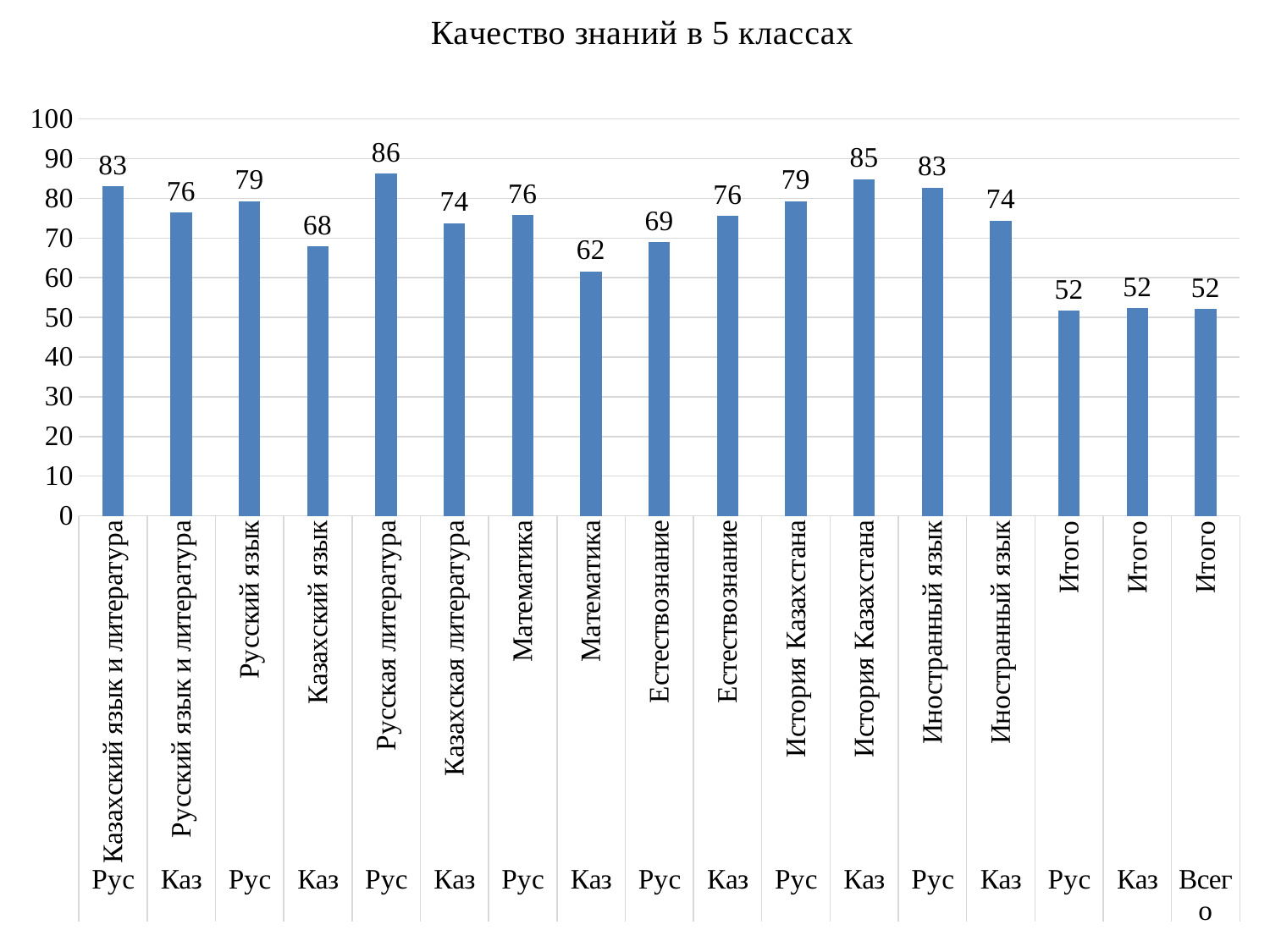
Which category has the highest value? Русская литература (Рус) What is the lowest value shown on the chart? 52 What is the value for Математика (Каз)? 62 How many bars are shown on the chart? 17 What is the title of the chart? Качество знаний в 5 классах What kind of chart is shown on the slide? bar chart What is the difference between История Казахстана (Каз) and История Казахстана (Рус)? 6 What is the value for Итого (Всего)? 52 Is the value for Казахский язык (Каз) greater or less than 70? less What is the difference between Математика (Рус) and Математика (Каз)? 14 What is the value for Русская литература (Рус)? 86 Which is larger: Естествознание (Рус) or Естествознание (Каз)? Естествознание (Каз)